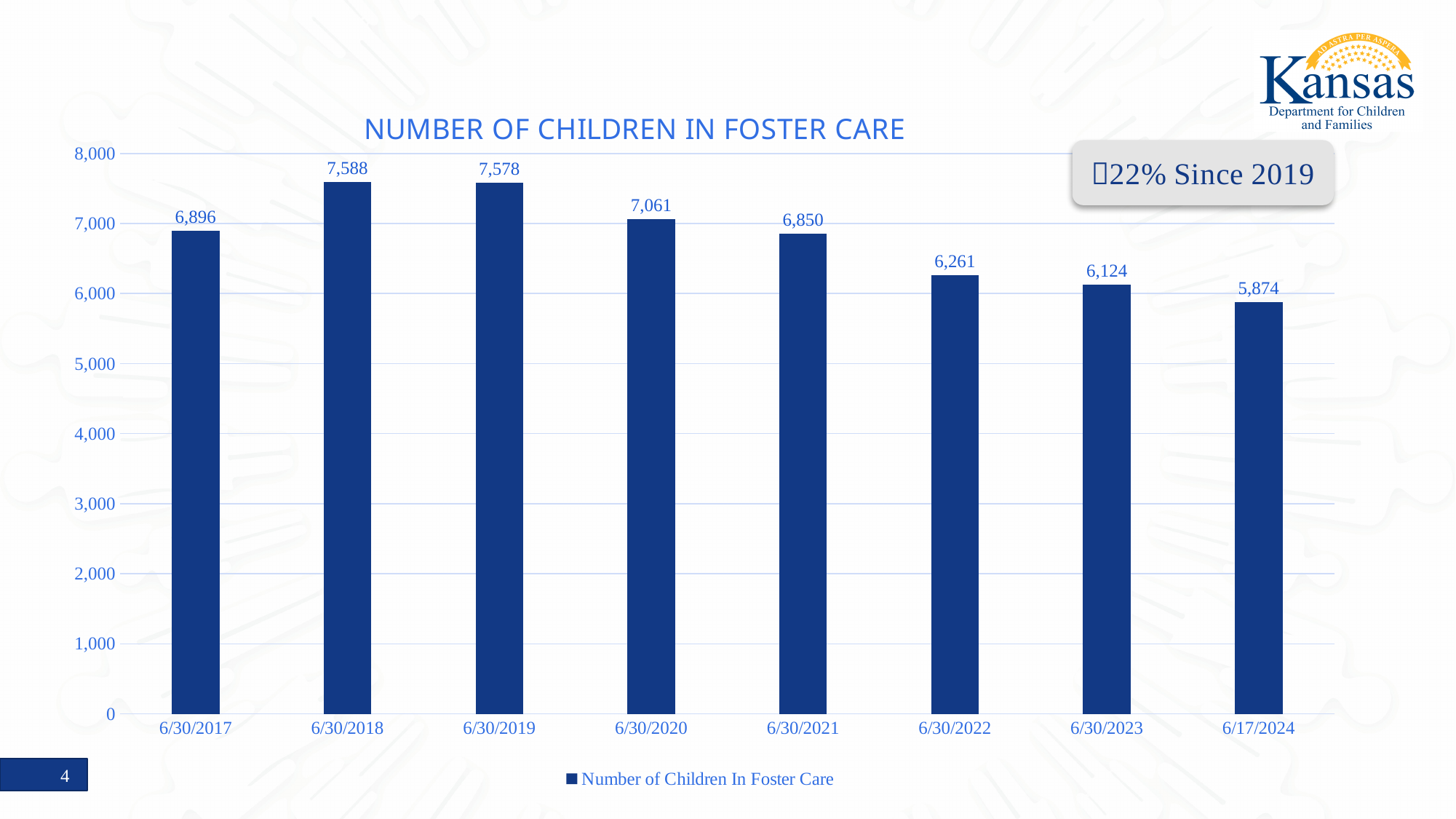
Which date has the lowest number of children in foster care? 6/17/2024 Which date has the highest number of children in foster care? 6/30/2018 What kind of chart is shown on the slide? bar chart Do the values rise or fall from 6/30/2019 to 6/17/2024? fall What is the number of children in foster care on 6/30/2021? 6,850 What is the number of children in foster care on 6/30/2017? 6,896 How many series does the legend list? 1 What is the number of children in foster care on 6/17/2024? 5,874 Which is larger, the value for 6/30/2020 or the value for 6/30/2022? 6/30/2020 How many dates are shown on the x axis of the chart? 8 What is the difference between the number of children in foster care on 6/30/2019 and on 6/17/2024? 1,704 Is the value for 6/30/2023 greater or less than 7,000? less